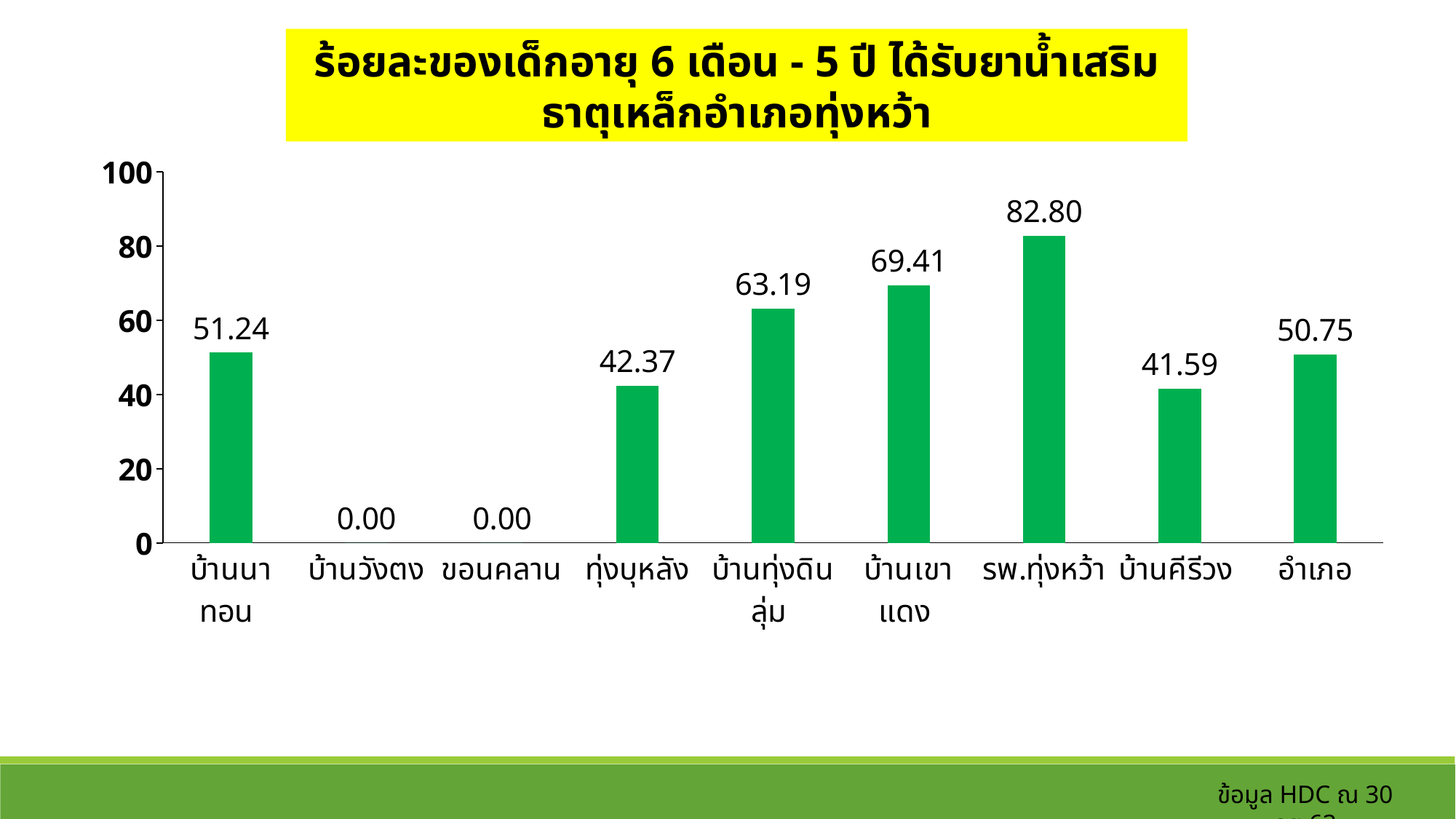
Which categories have a value of 0.00? บ้านวังตง and ขอนคลาน What is the value for บ้านนาทอน? 51.24 What kind of chart is shown on the slide? bar chart Which is larger, the value for บ้านทุ่งดินลุ่ม or the value for ทุ่งบุหลัง? บ้านทุ่งดินลุ่ม What is the value for รพ.ทุ่งหว้า? 82.80 What is the value for อำเภอ? 50.75 Is the value for บ้านเขาแดง greater or less than 60? greater What is the value for บ้านคีรีวง? 41.59 What is the difference between the values for รพ.ทุ่งหว้า and บ้านเขาแดง? 13.39 How many categories are shown on the x axis? 9 What colour are the bars in the chart? green Which category has the highest value? รพ.ทุ่งหว้า